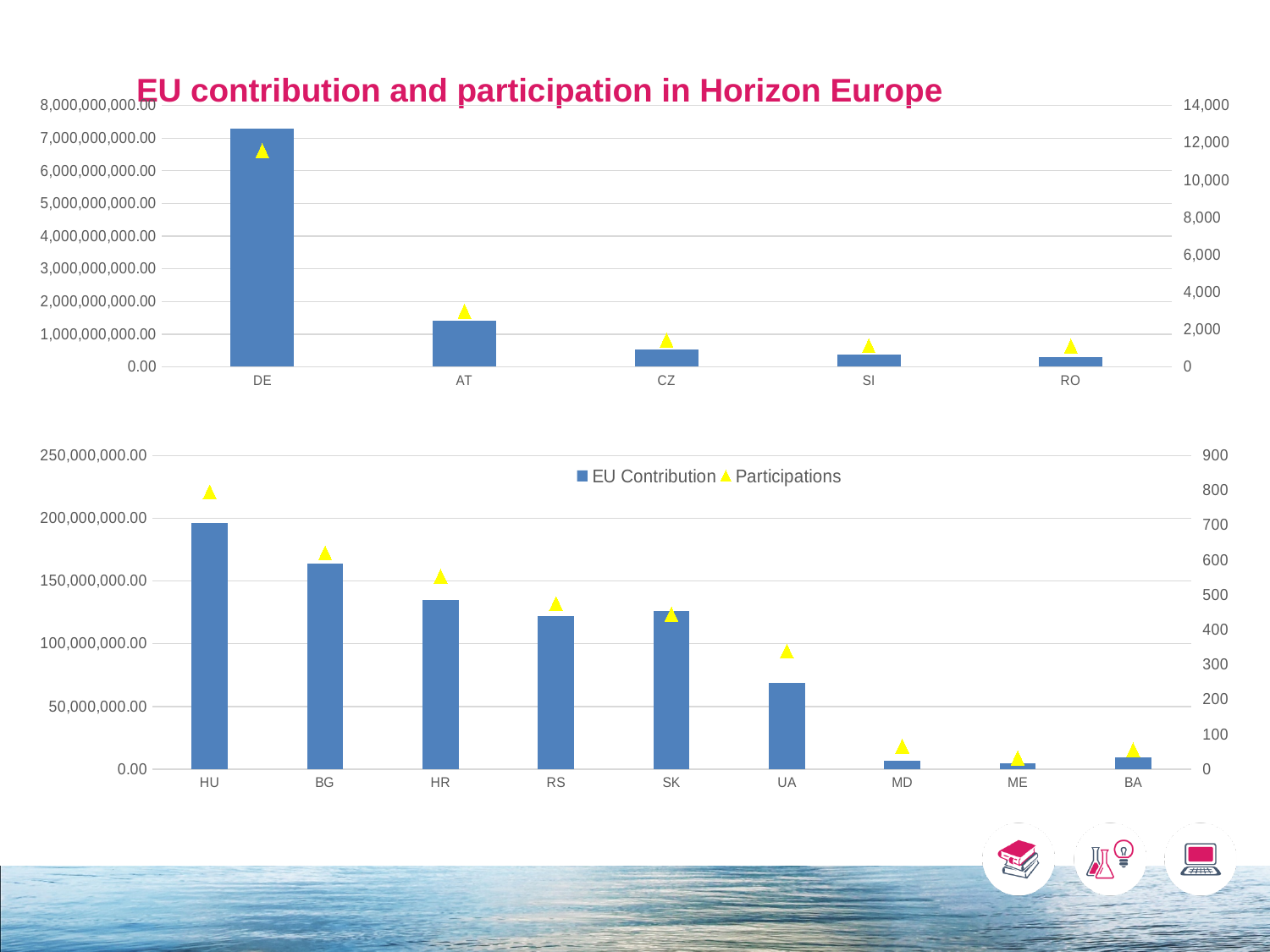
In the bottom chart, is the EU Contribution for UA greater or less than 50,000,000.00? greater How many series does the legend on the bottom chart list? 2 In the top chart, which country has the highest EU Contribution? DE In the top chart, is the number of Participations for DE greater or less than 10,000? greater In the bottom chart, which has the larger EU Contribution, BG or UA? BG What kind of chart is the top chart on the slide? bar chart (with a line/marker series for participations) In the top chart, is the EU Contribution for DE greater or less than 7,000,000,000.00? greater How many countries are shown on the x axis of the bottom chart? 9 How many countries are shown on the x axis of the top chart? 5 In the top chart, do the EU Contribution bars rise or fall from DE to RO? fall In the bottom chart, which country has the highest EU Contribution? HU